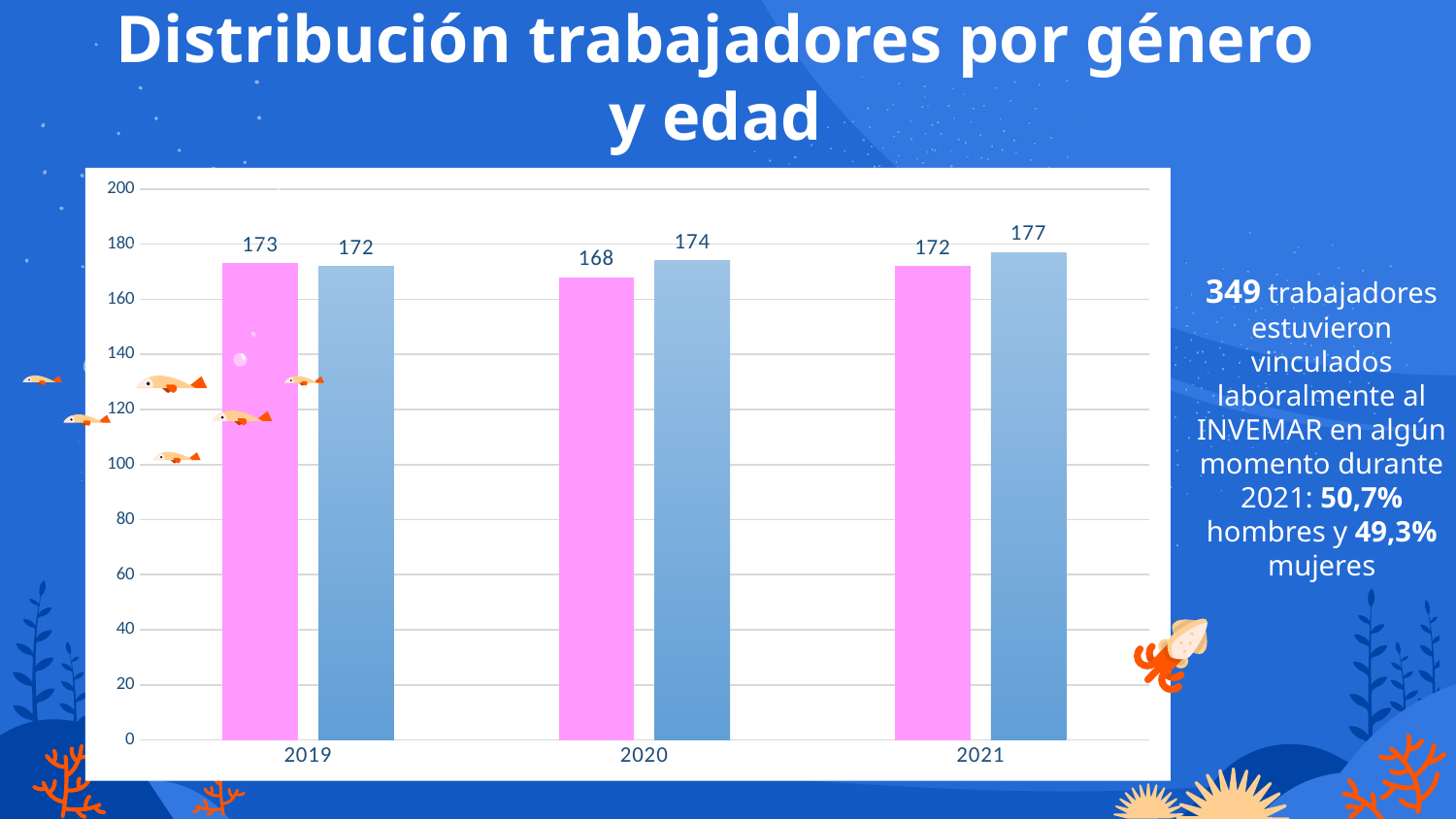
What is the value of the blue bar for 2020? 174 In 2019, which bar is larger, the pink bar or the blue bar? the pink bar What is the value of the pink bar for 2020? 168 In which year is the pink bar lowest? 2020 What kind of chart is shown on the slide? bar chart What is the value of the blue bar for 2021? 177 How many years are shown on the x axis of the chart? 3 In which year is the blue bar highest? 2021 What is the value of the pink bar for 2019? 173 What is the difference between the blue bar and the pink bar in 2021? 5 Do the blue bars rise or fall from 2019 to 2021? rise What is the difference between the blue bar and the pink bar in 2020? 6